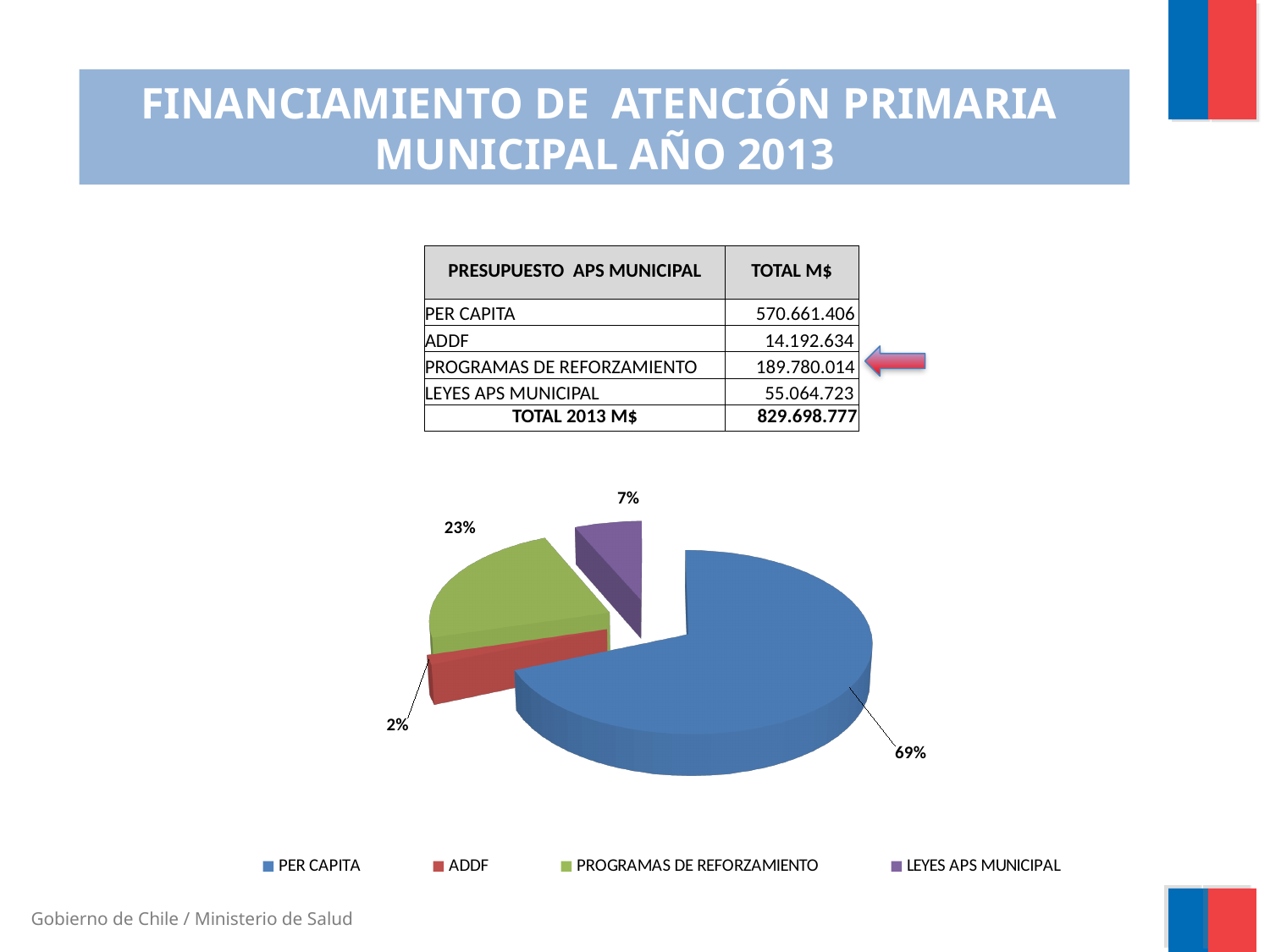
How many slices does the pie chart have? 4 What share of the pie does PROGRAMAS DE REFORZAMIENTO represent? 23% Which slice is larger, PROGRAMAS DE REFORZAMIENTO or LEYES APS MUNICIPAL? PROGRAMAS DE REFORZAMIENTO What kind of chart is shown on the slide? pie chart What share of the pie does PER CAPITA represent? 69% What share of the pie does LEYES APS MUNICIPAL represent? 7% How many percentage points larger is the PER CAPITA share than the PROGRAMAS DE REFORZAMIENTO share? 46 percentage points How many entries does the legend of the pie chart list? 4 Which category has the smallest slice of the pie? ADDF Which category has the largest slice of the pie? PER CAPITA What colour is the PROGRAMAS DE REFORZAMIENTO slice in the pie chart? green